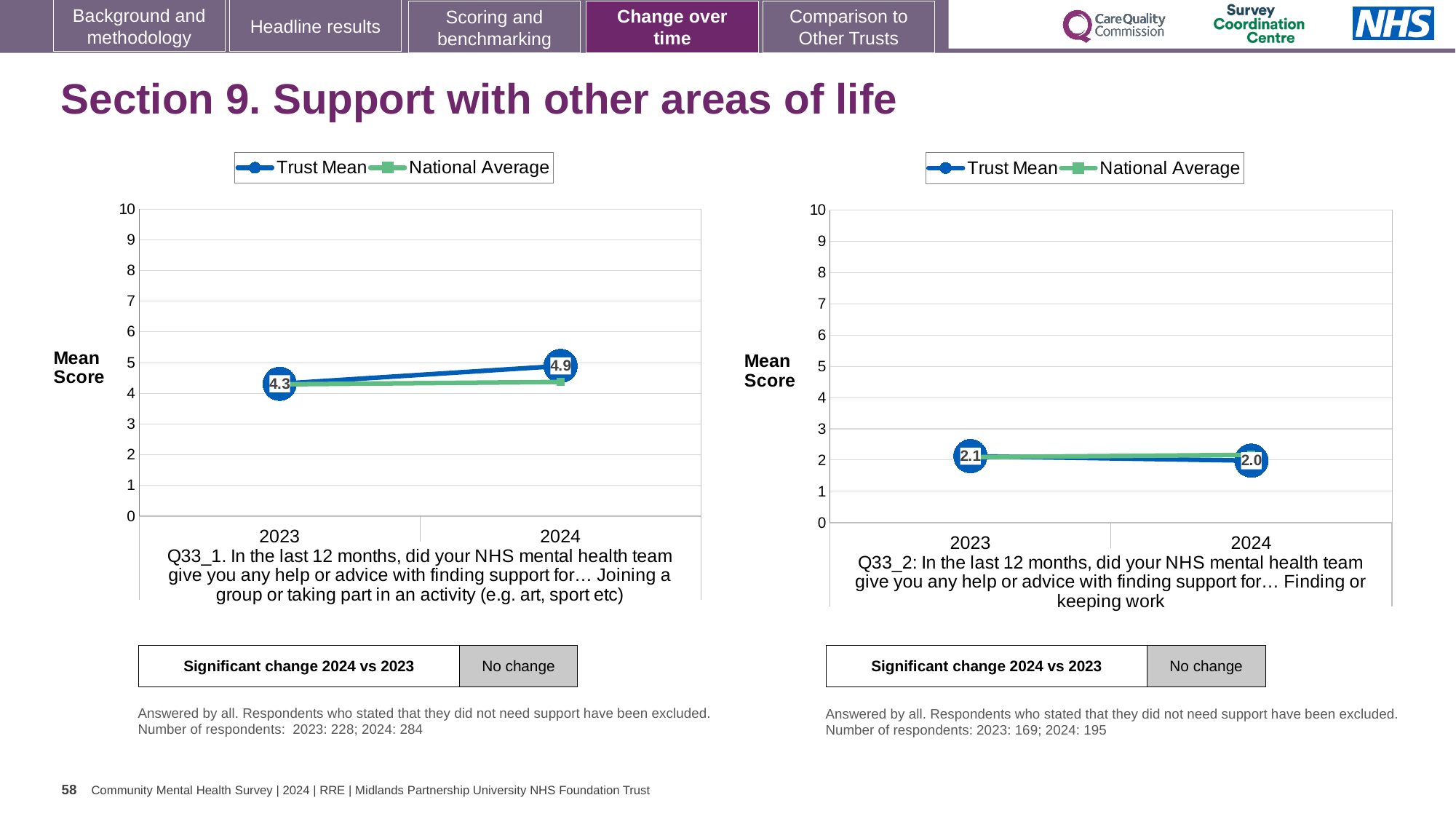
What kind of chart is the left chart (Q33_1)? line chart How many years are shown on the x axis of the left chart (Q33_1)? 2 In the left chart (Q33_1), does the Trust Mean rise or fall from 2023 to 2024? rise In the left chart (Q33_1), by how much did the Trust Mean change from 2023 to 2024? 0.6 In the right chart (Q33_2), does the Trust Mean rise or fall from 2023 to 2024? fall In the right chart (Q33_2), what is the Trust Mean for 2024? 2.0 In the left chart (Q33_1), what is the Trust Mean for 2024? 4.9 In the right chart (Q33_2), is the Trust Mean for 2024 greater or less than 5? less In the left chart (Q33_1), what is the Trust Mean for 2023? 4.3 In the right chart (Q33_2), what is the Trust Mean for 2023? 2.1 In the left chart (Q33_1), which year has the higher Trust Mean, 2023 or 2024? 2024 How many series does the legend of the right chart (Q33_2) list? 2